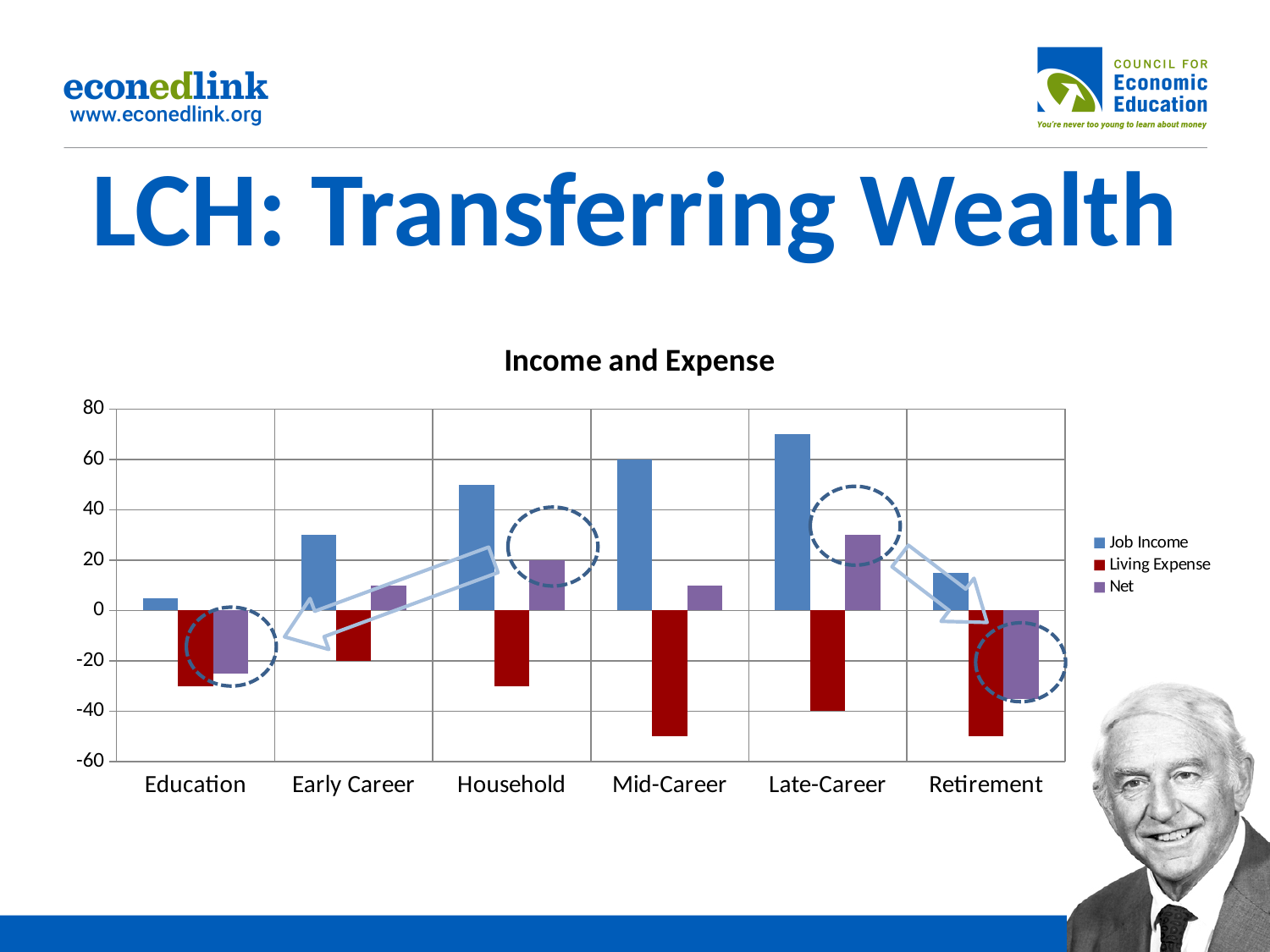
Which category has the highest Net value? Late-Career Is the Living Expense value for Mid-Career greater or less than -40? less How many life-stage categories are shown on the x axis? 6 What is the title of the chart? Income and Expense What kind of chart is shown on the slide? bar chart Is the Job Income value for Late-Career greater or less than 60? greater How many series does the legend list? 3 Which category has the lowest Net value? Retirement Which category has the lowest Job Income? Education Does Job Income rise or fall from Education through Late-Career? rise Which is larger, the Job Income for Household or the Job Income for Early Career? Household Which category has the highest Job Income? Late-Career